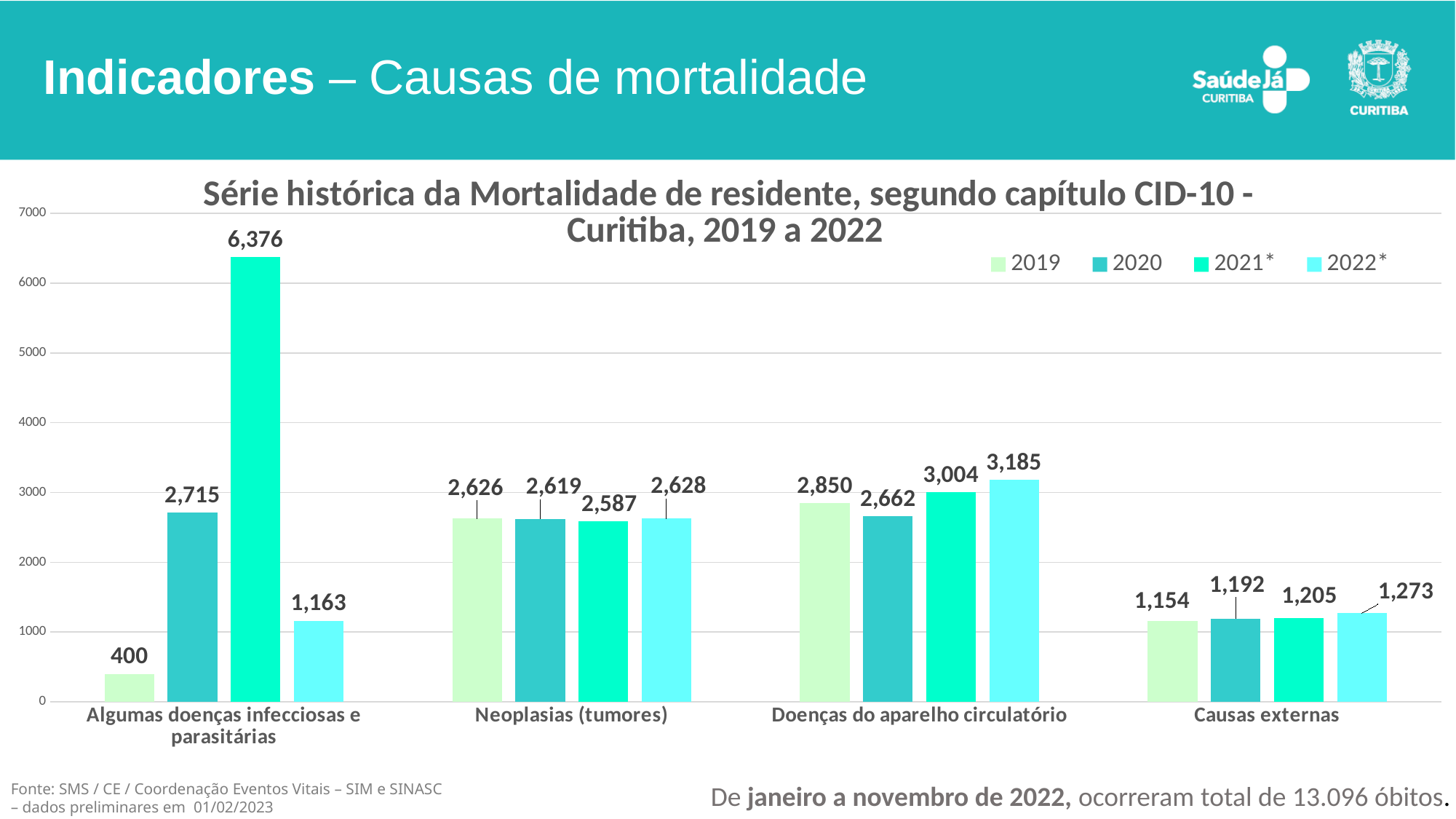
Which is larger: the 2019 value or the 2020 value for 'Doenças do aparelho circulatório'? 2019 How many categories are shown on the x axis? 4 What kind of chart is shown on the slide? bar chart Is the 2020 value for 'Algumas doenças infecciosas e parasitárias' greater or less than 3000? less Which category has the lowest value for the 2019 series? Algumas doenças infecciosas e parasitárias What is the value for 2021* in the 'Algumas doenças infecciosas e parasitárias' category? 6,376 Do the values for 'Causas externas' rise or fall from 2019 to 2022*? rise What is the difference between the 2021* and 2022* values for 'Algumas doenças infecciosas e parasitárias'? 5,213 What is the value for 2022* in the 'Doenças do aparelho circulatório' category? 3,185 How many series does the legend list? 4 Which category has the highest value for the 2021* series? Algumas doenças infecciosas e parasitárias What is the value for 2019 in the 'Causas externas' category? 1,154